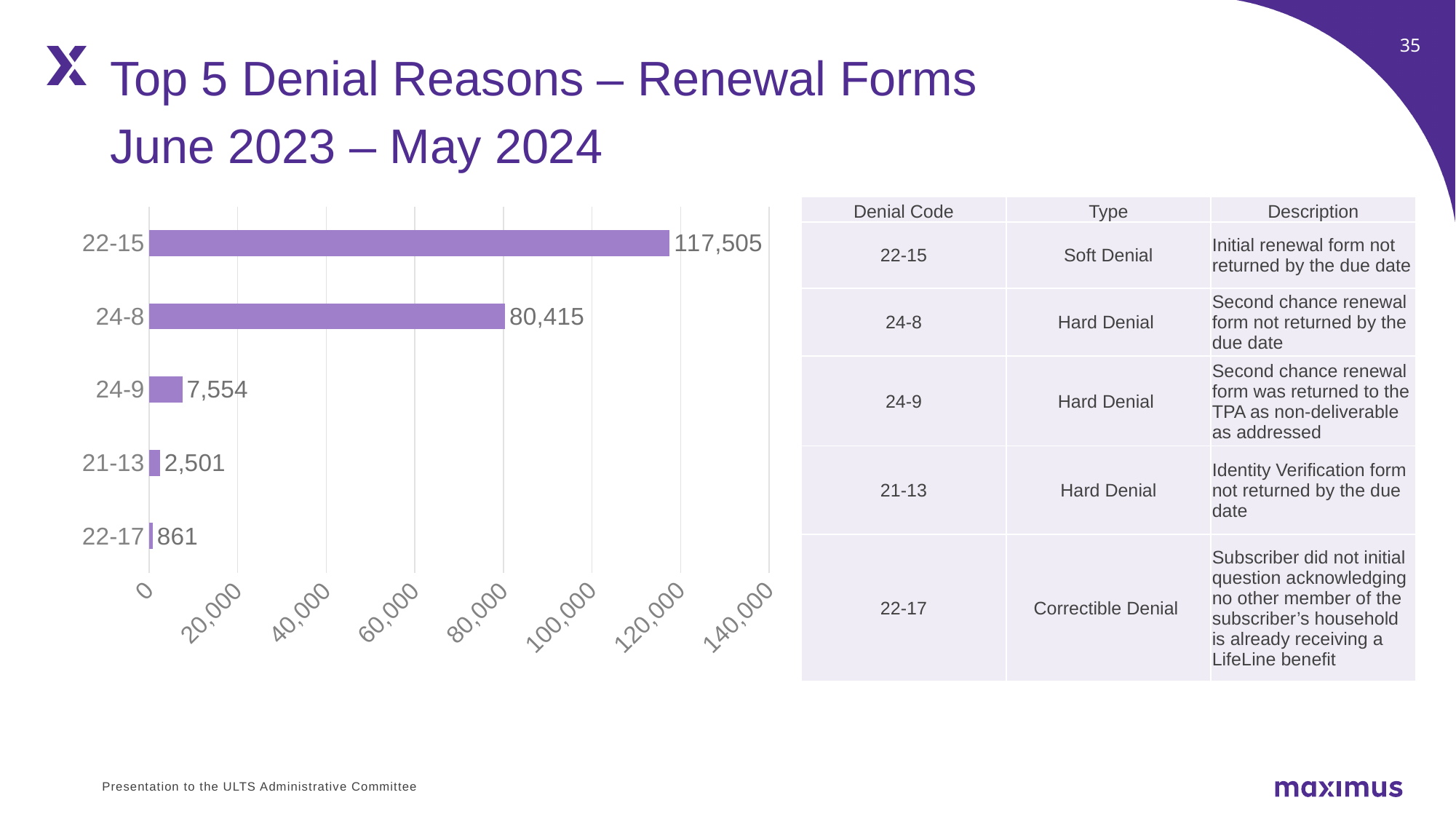
What is the value for denial code 24-8? 80,415 Which has a larger value, 24-9 or 21-13? 24-9 What is the value for denial code 22-17? 861 What is the value for denial code 22-15? 117,505 Which denial code has the lowest value? 22-17 How many denial codes are shown in the chart? 5 Is the value for 24-8 greater or less than 100,000? less What kind of chart is shown on the slide? bar chart What is the value for denial code 21-13? 2,501 Which denial code has the highest value? 22-15 What is the value for denial code 24-9? 7,554 What is the difference between the values for 22-15 and 24-8? 37,090